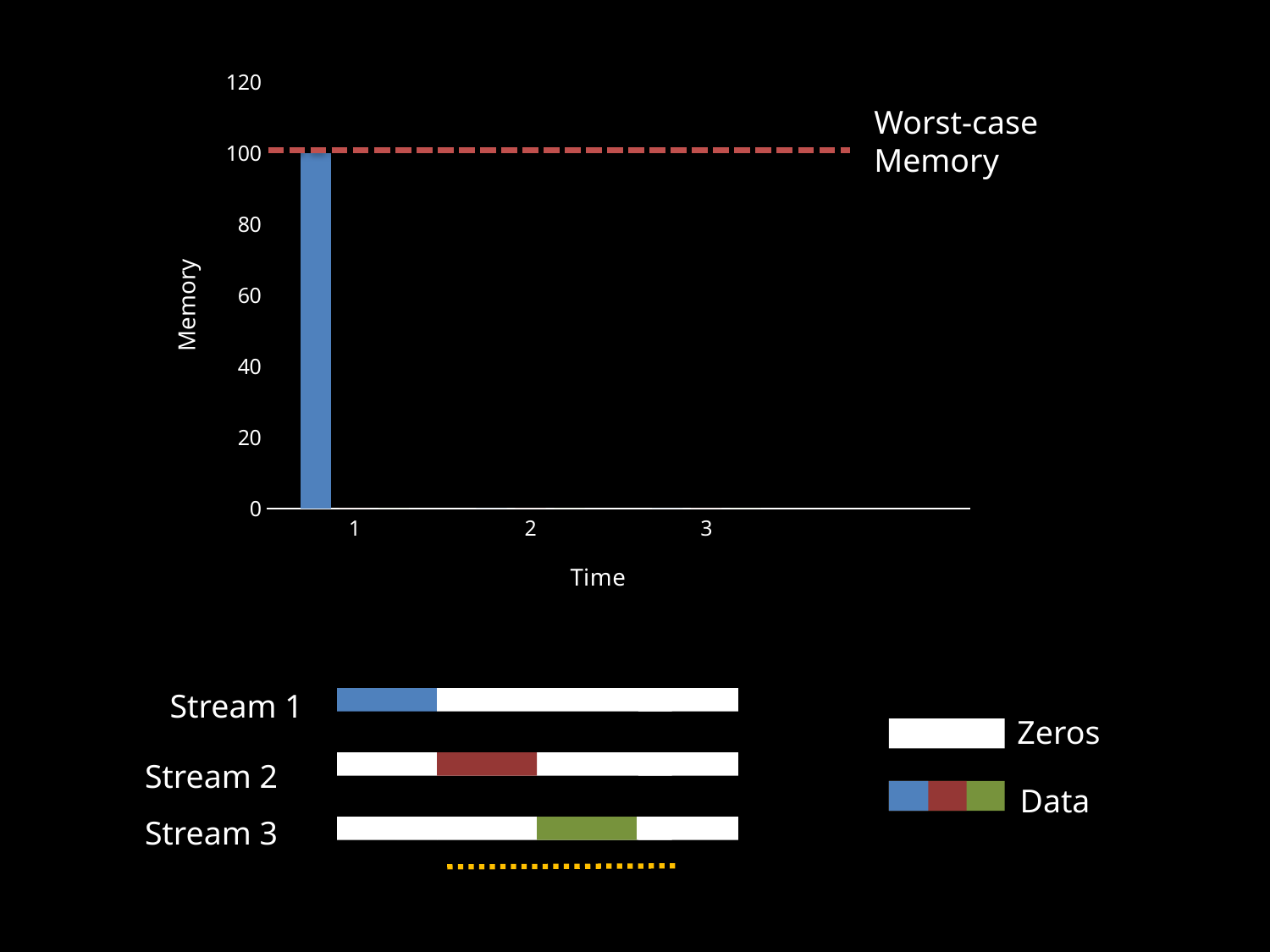
At which time point is the memory value highest? 1 How many time points are labelled on the x axis? 3 Is the memory value at time 1 greater or less than 80? greater What is the highest value shown on the y axis? 120 How many bars are plotted in the chart? 1 Is the memory value at time 1 greater or less than 120? less What is the label of the y axis? Memory What kind of chart is shown on the slide? bar chart What is the memory value plotted at time 1? 100 What does the dashed horizontal line at 100 represent? Worst-case Memory